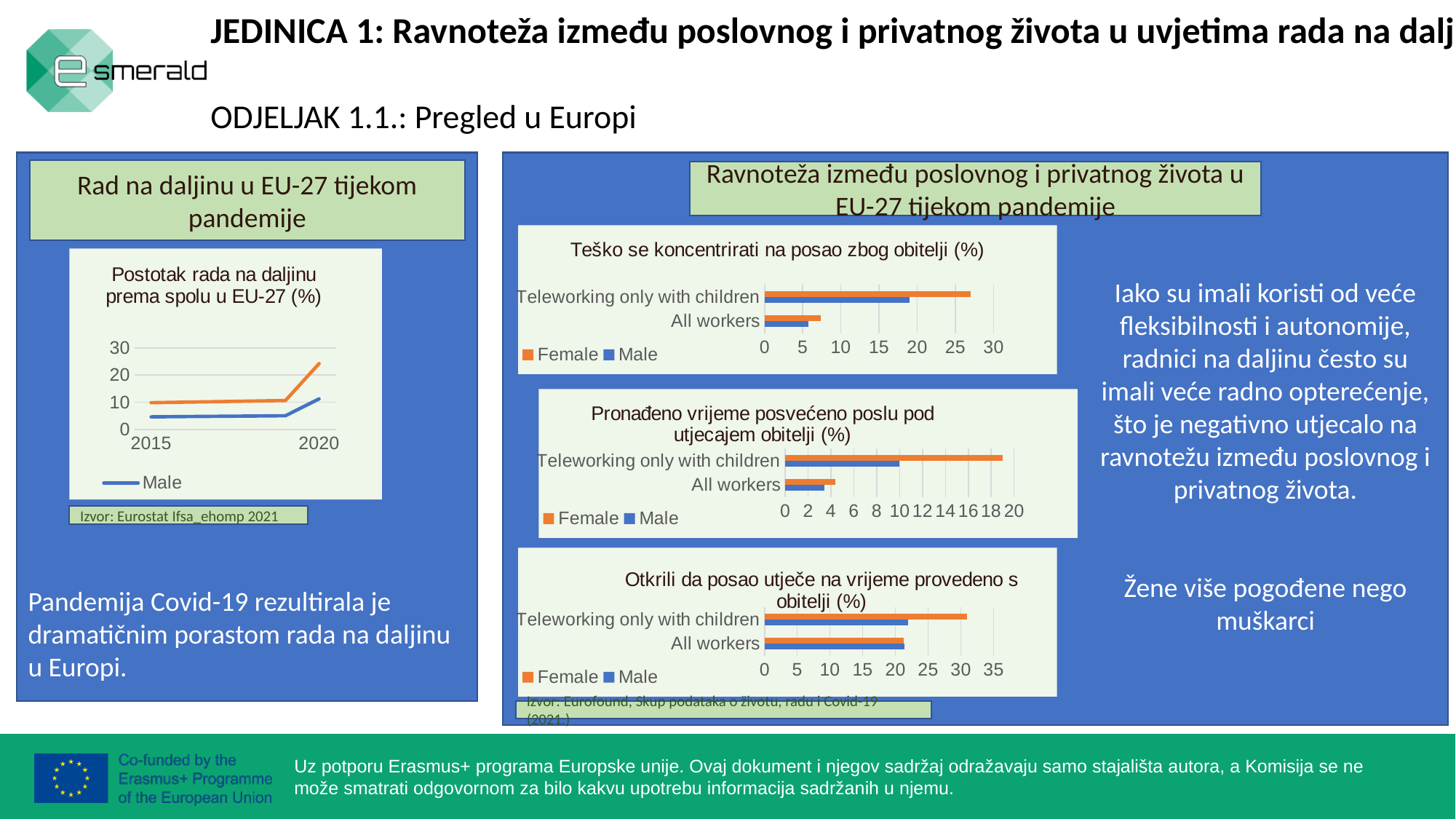
In the chart titled 'Teško se koncentrirati na posao zbog obitelji (%)', how many series does the legend list? 2 In the chart titled 'Postotak rada na daljinu prema spolu u EU-27 (%)', which years are shown on the x axis? 2015 and 2020 In the chart titled 'Teško se koncentrirati na posao zbog obitelji (%)', what kind of chart is it? bar chart In the chart titled 'Pronađeno vrijeme posvećeno poslu pod utjecajem obitelji (%)', which category has the highest Female value? Teleworking only with children In the chart titled 'Otkrili da posao utječe na vrijeme provedeno s obitelji (%)', which series is shown in orange? Female In the chart titled 'Teško se koncentrirati na posao zbog obitelji (%)', which is larger for 'All workers', Female or Male? Female In the chart titled 'Postotak rada na daljinu prema spolu u EU-27 (%)', what kind of chart is it? line chart In the chart titled 'Pronađeno vrijeme posvećeno poslu pod utjecajem obitelji (%)', is the Male value for 'Teleworking only with children' greater or less than 14? less In the chart titled 'Postotak rada na daljinu prema spolu u EU-27 (%)', do the values rise or fall from 2015 to 2020? rise In the chart titled 'Otkrili da posao utječe na vrijeme provedeno s obitelji (%)', is the Female value for 'Teleworking only with children' greater or less than 30? greater In the chart titled 'Pronađeno vrijeme posvećeno poslu pod utjecajem obitelji (%)', how many categories are shown? 2 In the chart titled 'Teško se koncentrirati na posao zbog obitelji (%)', is the Female value for 'Teleworking only with children' greater or less than 25? greater